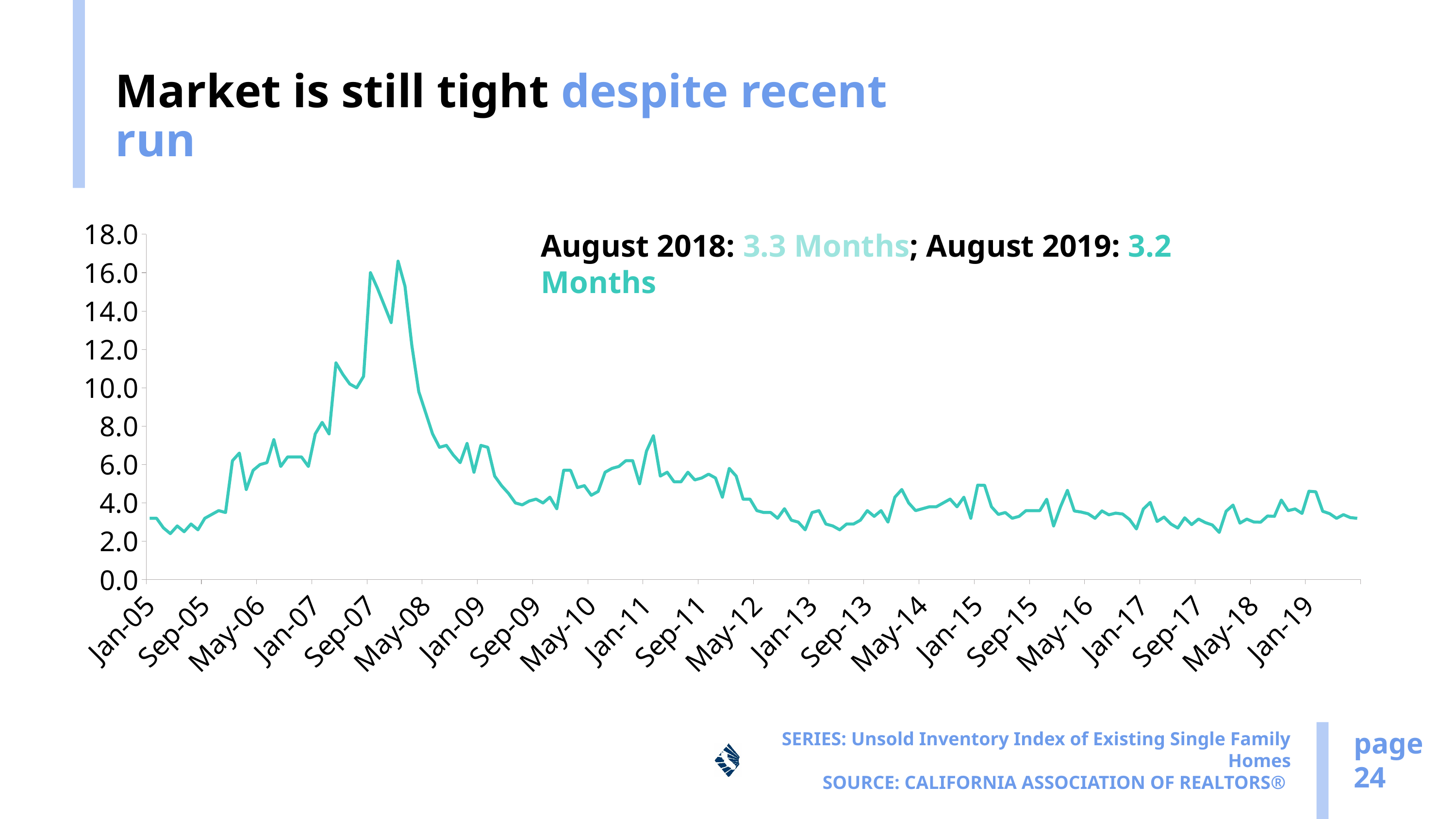
Is the highest point of the line greater or less than 14.0? greater What kind of chart is shown on the slide? line chart What was the Unsold Inventory Index value in August 2018? 3.3 Months Which is larger, the August 2018 value or the August 2019 value? August 2018 What was the Unsold Inventory Index value in August 2019? 3.2 Months What is the difference between the August 2018 and August 2019 values? 0.1 Months What is the highest value shown on the y axis? 18.0 What is the title of the slide? Market is still tight despite recent run Do the values rise or fall between May-08 and Jan-09? fall Is the value at Jan-05 greater or less than 4.0? less Is the value at Jan-13 greater or less than 4.0? less In which year does the line reach its highest point? 2008